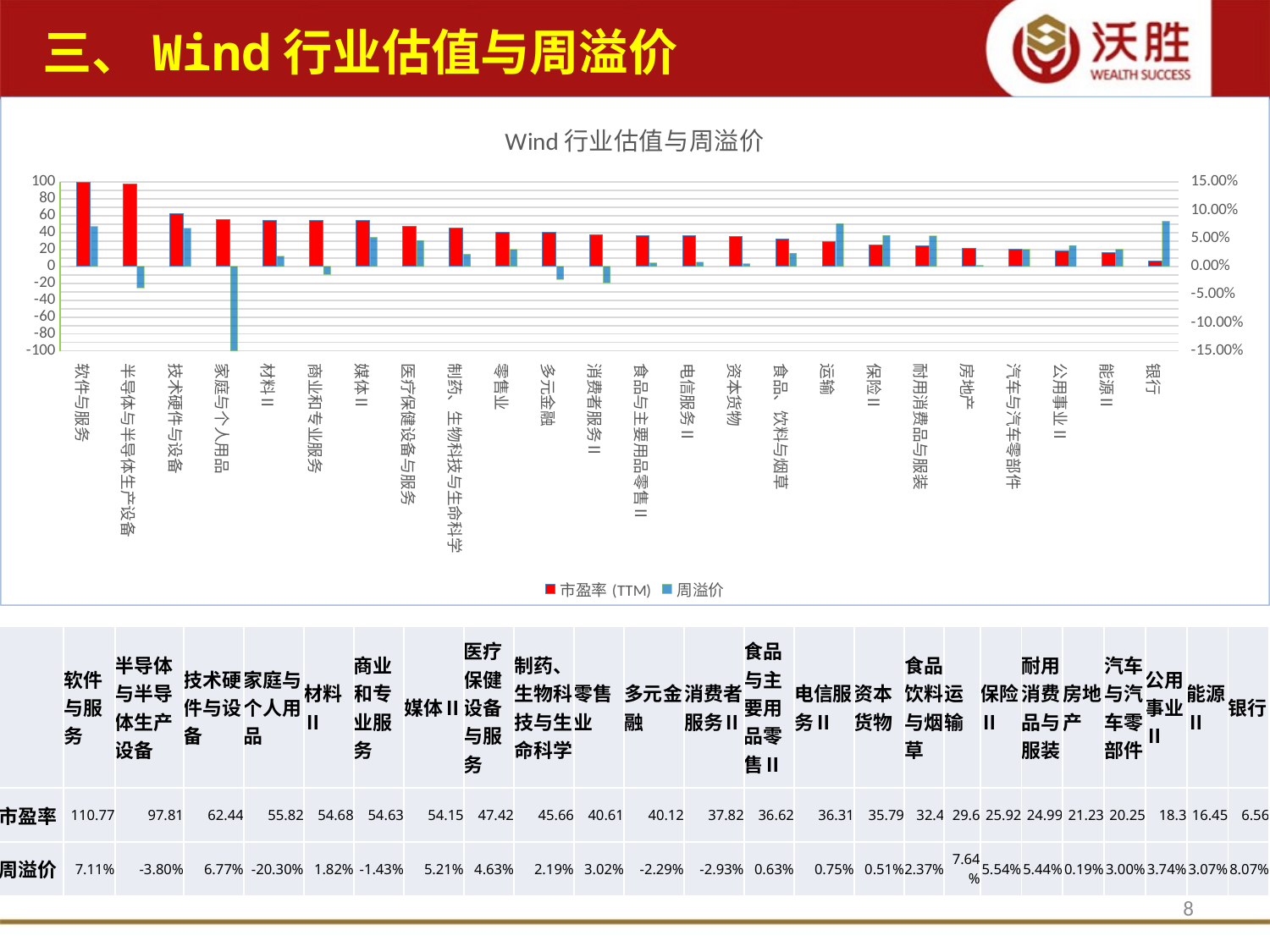
How many series does the chart legend list? 2 Do the 市盈率 (TTM) values rise or fall moving from left to right along the x axis? fall Which has a higher 市盈率 (TTM), 技术硬件与设备 or 家庭与个人用品? 技术硬件与设备 Which category has the lowest 市盈率 (TTM)? 银行 What type of chart is shown on the slide? bar chart What is the 市盈率 (TTM) value for 软件与服务? 110.77 What is the difference in 市盈率 (TTM) between 软件与服务 and 半导体与半导体生产设备? 12.96 Which category has the lowest 周溢价? 家庭与个人用品 What is the title of the chart? Wind 行业估值与周溢价 What is the 周溢价 value for 家庭与个人用品? -20.30% Which category has the highest 市盈率 (TTM)? 软件与服务 How many industry categories are plotted on the chart? 24